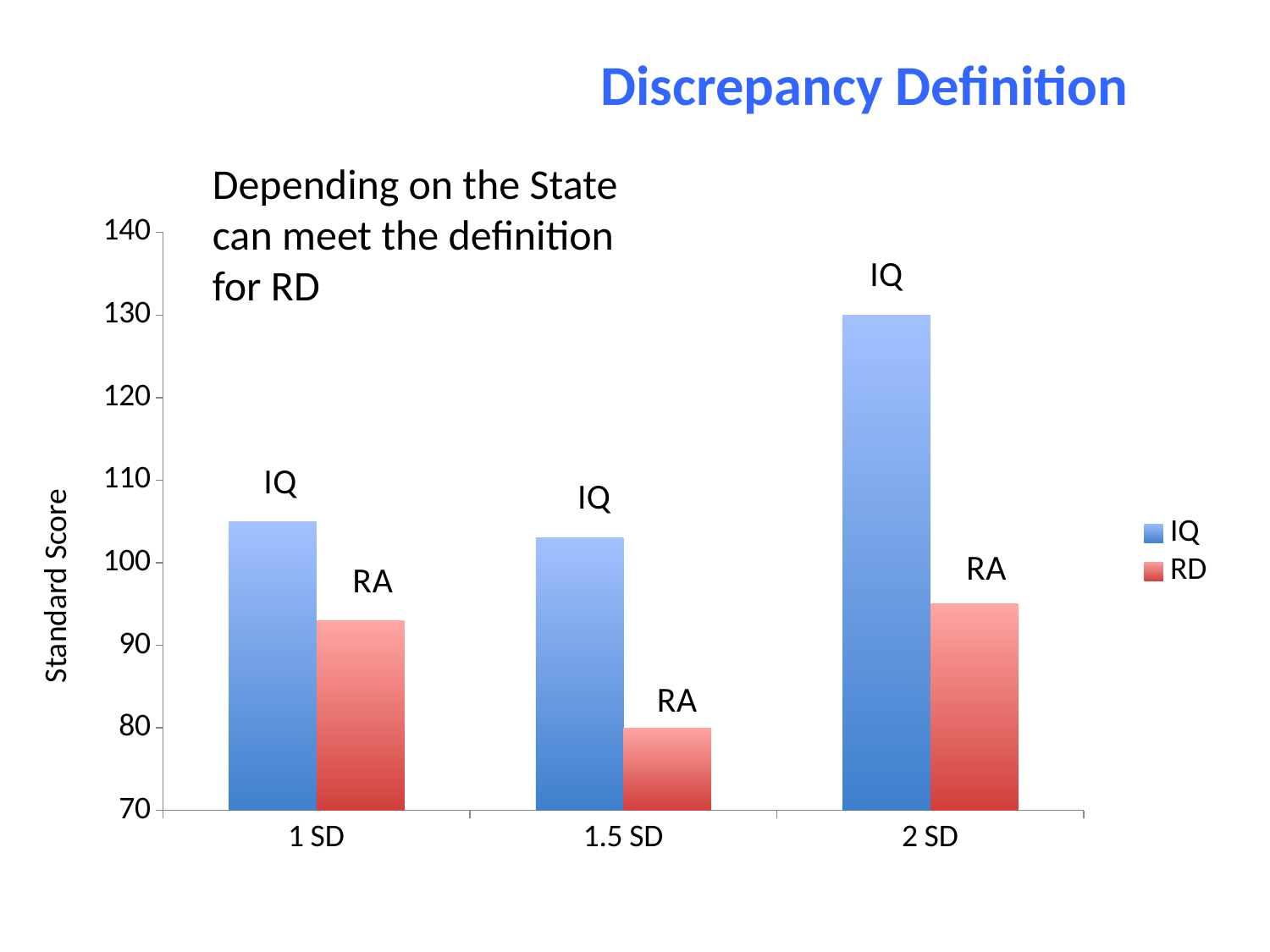
What is the RD (RA) value for the 1.5 SD category? 80 How many categories are shown on the x axis? 3 Which is larger for the 2 SD category, the IQ bar or the RD bar? IQ Which category has the lowest RD bar? 1.5 SD Is the RD value for 1 SD greater or less than 100? less How many series does the legend list? 2 What kind of chart is shown on the slide? bar chart Is the IQ value for 1 SD greater or less than 100? greater Is the RD value for 2 SD greater or less than 90? greater What is the IQ value for the 2 SD category? 130 What is the label on the vertical axis? Standard Score Which category has the highest IQ bar? 2 SD